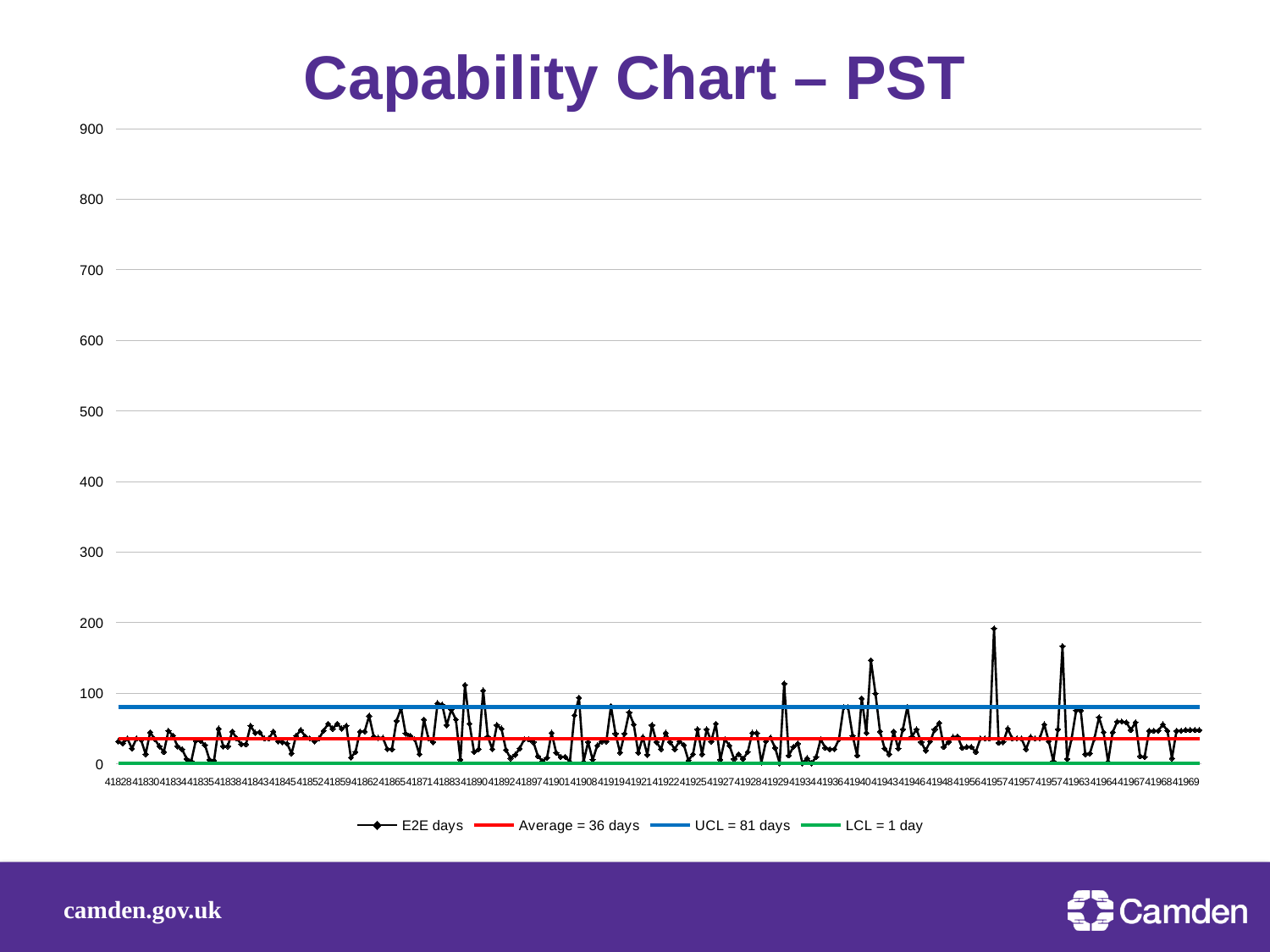
What is the maximum value shown on the y axis? 900 What value does the legend give for the Average line? 36 days What kind of chart is shown on the slide? line chart What is the difference between the UCL and the Average values shown in the legend? 45 days What value does the legend give for the LCL line? 1 day What value does the legend give for the UCL line? 81 days Is the highest E2E days point greater or less than 100? greater What is the difference between the Average and the LCL values shown in the legend? 35 days Is the highest E2E days point greater or less than 300? less How many series does the legend list? 4 Which is larger, the UCL value or the Average value? UCL What is the title of the chart? Capability Chart – PST